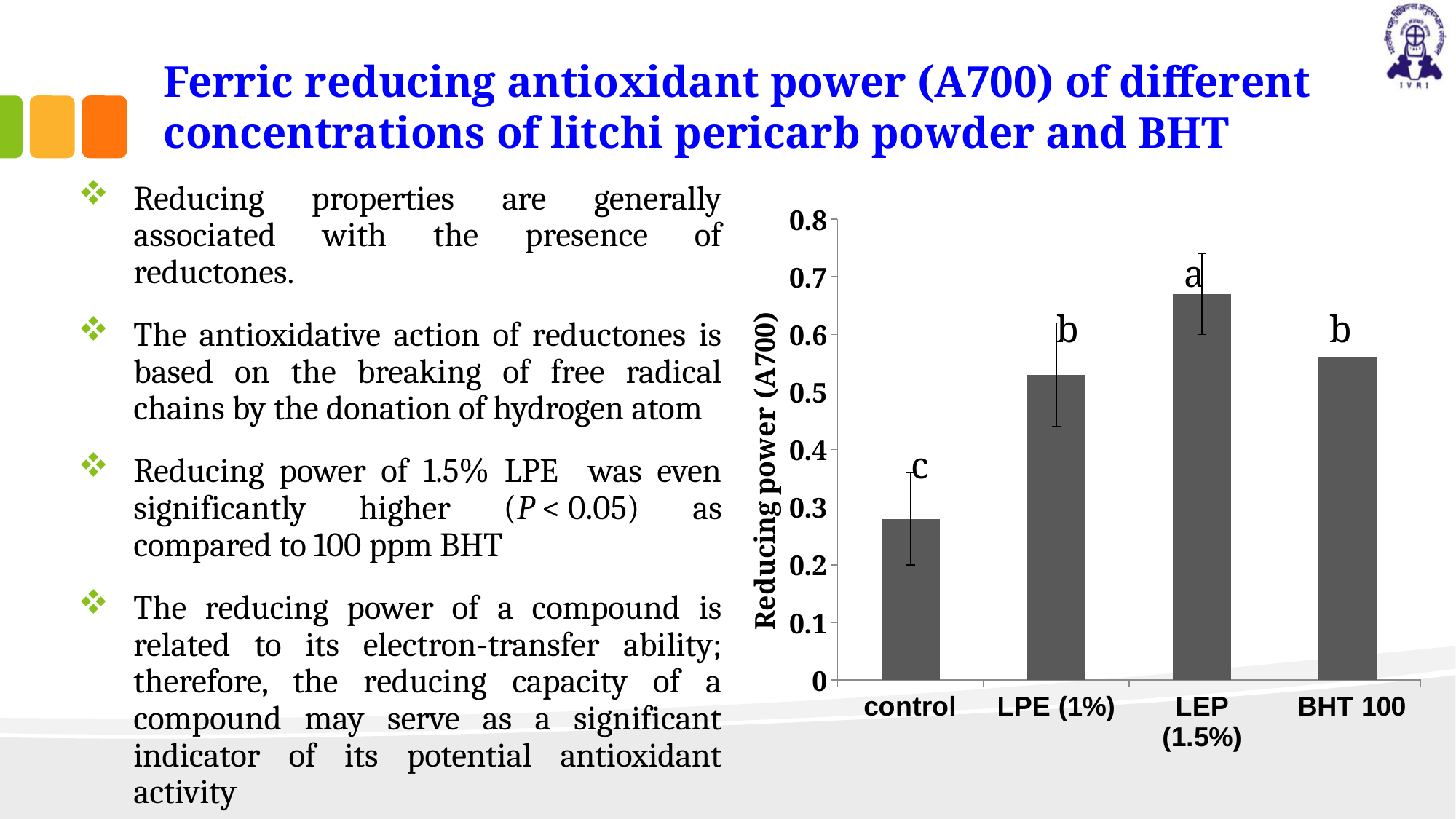
Is the value for BHT 100 greater or less than 0.5? greater Is the value for LEP (1.5%) greater or less than 0.6? greater What kind of chart is shown on the slide? bar chart Is the value for LPE (1%) greater or less than 0.4? greater What is the label of the y axis of the chart? Reducing power (A700) Which has a higher reducing power, LEP (1.5%) or BHT 100? LEP (1.5%) Which category has the highest reducing power (A700)? LEP (1.5%) Which has a higher reducing power, LPE (1%) or control? LPE (1%) Which category has the lowest reducing power (A700)? control How many categories are plotted on the x axis of the chart? 4 Which has a higher reducing power, LEP (1.5%) or control? LEP (1.5%)